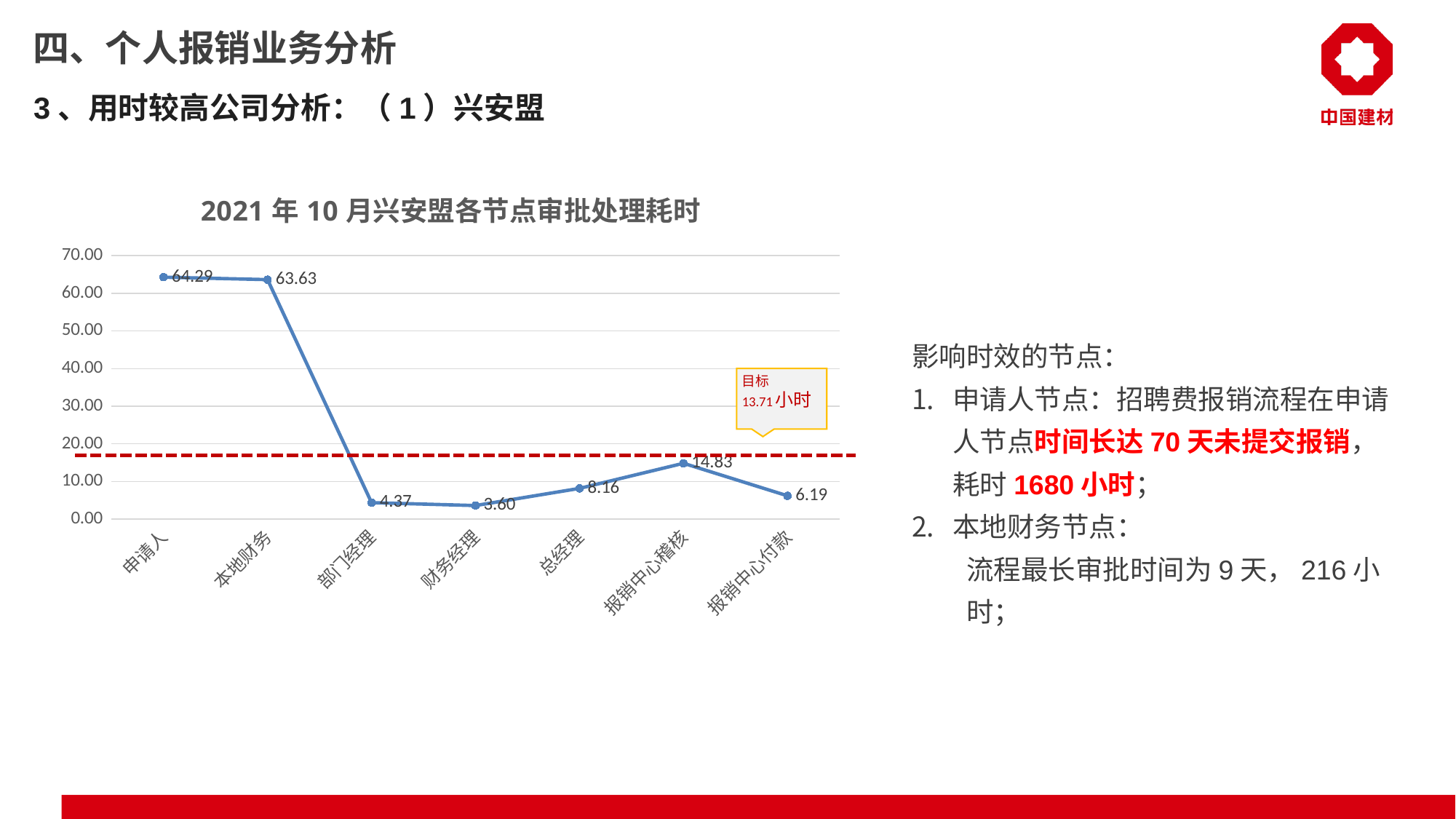
What is the difference between the values for 申请人 and 本地财务? 0.66 What is the value for 报销中心付款? 6.19 How many categories are plotted on the x axis? 7 What is the value for 报销中心稽核? 14.83 What is the value for 本地财务? 63.63 Which is larger, the value for 总经理 or the value for 部门经理? 总经理 What is the value for 申请人? 64.29 What is the title of the chart? 2021年10月兴安盟各节点审批处理耗时 Which category has the lowest value? 财务经理 Which category has the highest value? 申请人 What target value is marked by the dashed red line on the chart? 13.71小时 What kind of chart is shown on the slide? Line chart